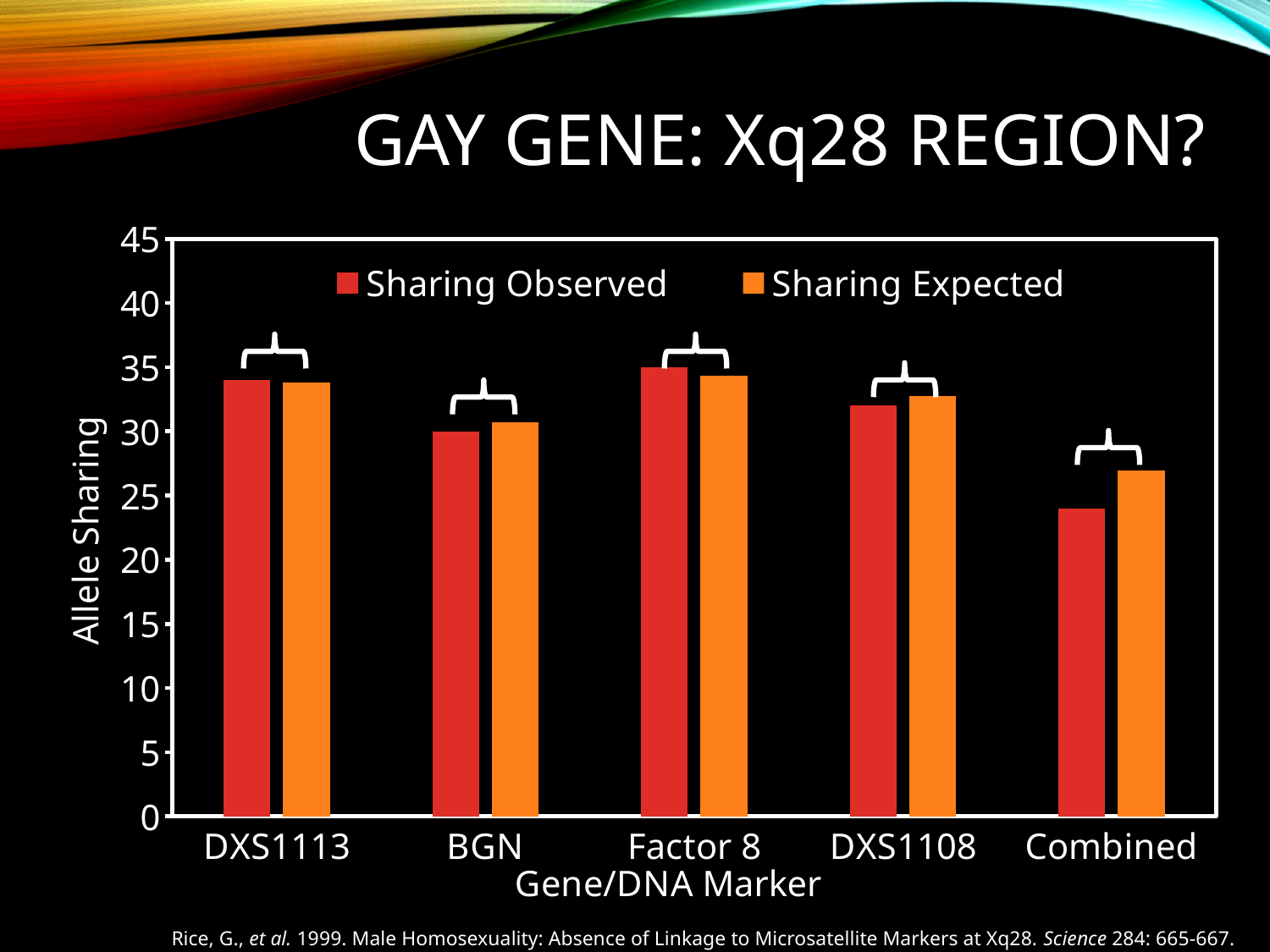
Which category has the lowest Sharing Observed value? Combined Which category has the lowest Sharing Expected value? Combined Is the Sharing Observed value for Factor 8 greater or less than 30? greater Is the Sharing Observed value for Combined greater or less than 25? less For the Combined category, which is larger: Sharing Observed or Sharing Expected? Sharing Expected How many gene/DNA marker categories are shown on the x axis? 5 Which is larger: the Sharing Observed value for Factor 8 or for Combined? Factor 8 What kind of chart is shown on the slide? bar chart How many series does the legend list? 2 What are the two series named in the legend? Sharing Observed and Sharing Expected What is the title of the y axis? Allele Sharing Is the Sharing Expected value for Combined greater or less than 25? greater